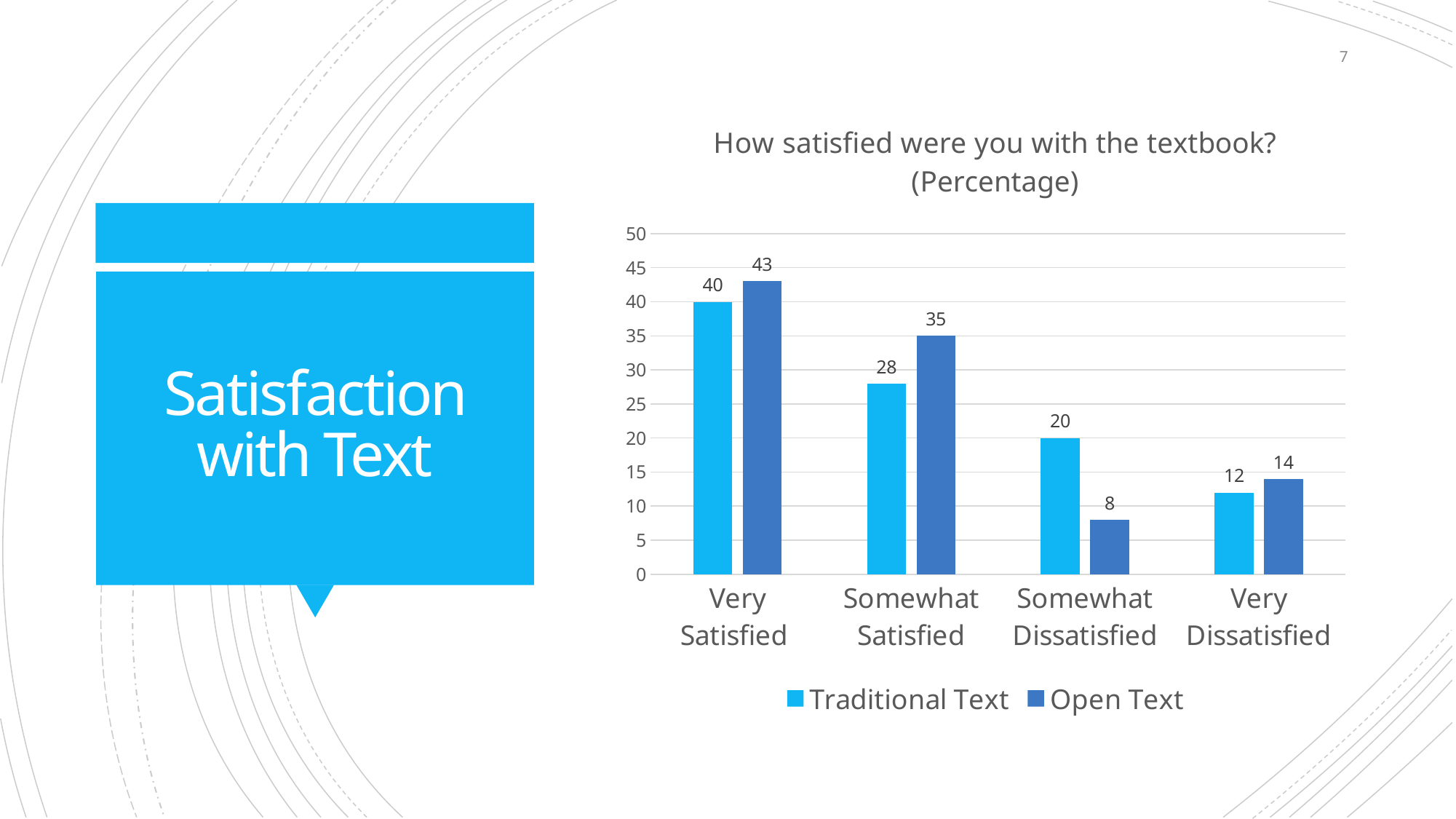
How many series does the legend list? 2 Which category has the lowest Traditional Text value? Very Dissatisfied What is the title of the chart? How satisfied were you with the textbook? (Percentage) What is the difference between the Open Text and Traditional Text values for Somewhat Satisfied? 7 What is the Open Text value for Somewhat Satisfied? 35 How many categories are shown on the x axis? 4 For Somewhat Dissatisfied, which series has the larger value, Traditional Text or Open Text? Traditional Text What is the Traditional Text value for Very Satisfied? 40 Which category has the highest Open Text value? Very Satisfied What is the Open Text value for Somewhat Dissatisfied? 8 What kind of chart is shown on the slide? Bar chart Do the Traditional Text values rise or fall from Very Satisfied to Very Dissatisfied? Fall